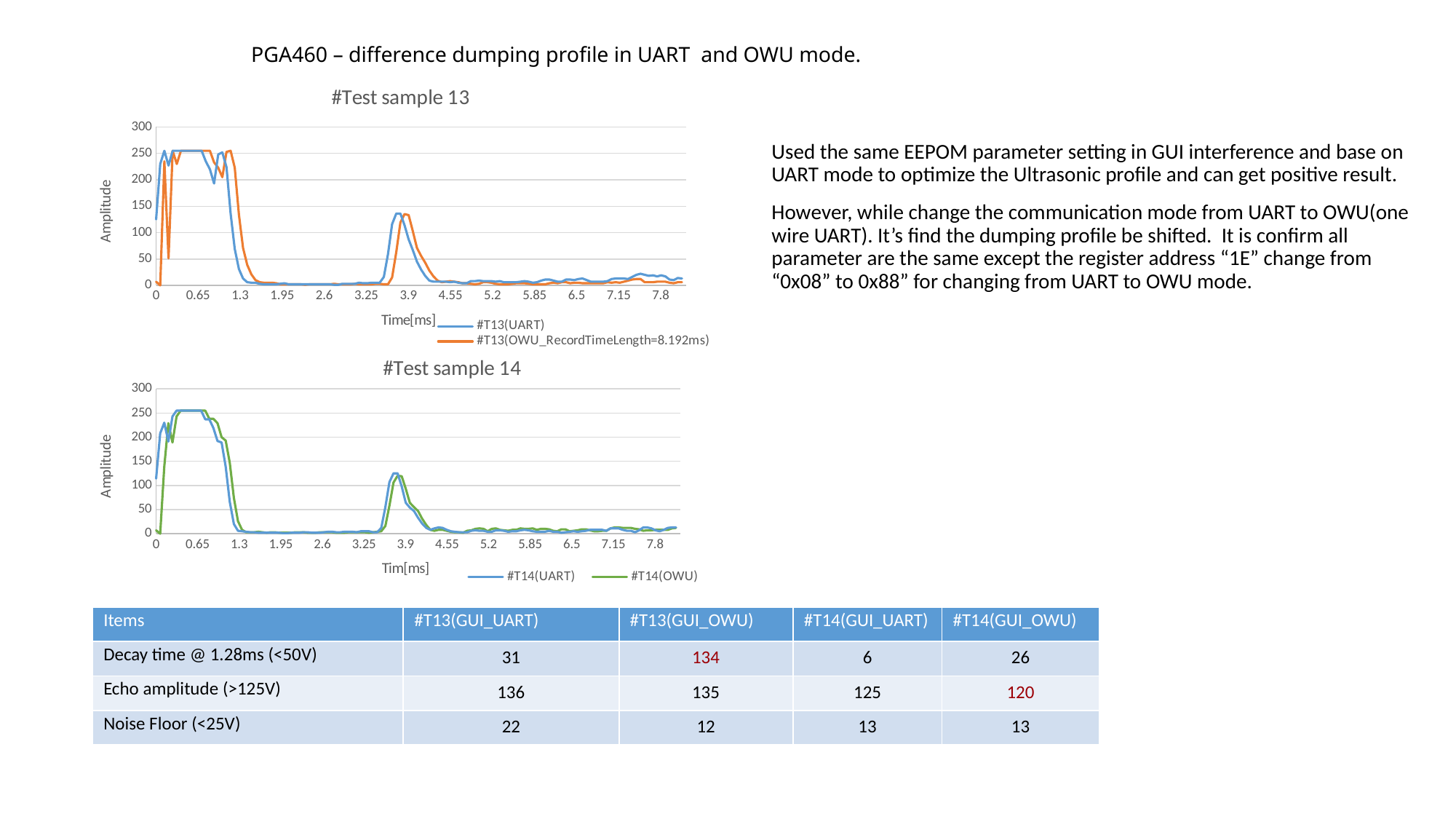
How many series does the legend of the "#Test sample 13" chart list? 2 In the "#Test sample 13" chart, what is the label of the orange series in the legend? #T13(OWU_RecordTimeLength=8.192ms) In the "#Test sample 14" chart, is the peak value of the #T14(UART) series near 3.9 ms greater or less than 100? greater How many series does the legend of the "#Test sample 14" chart list? 2 In the "#Test sample 14" chart, is the value of the #T14(OWU) series at 0.65 ms greater or less than 200? greater What kind of chart is "#Test sample 13"? line chart In the "#Test sample 13" chart, is the value of the #T13(UART) series at 2.6 ms greater or less than 50? less What kind of chart is "#Test sample 14"? line chart In the "#Test sample 14" chart, what is the label of the green series in the legend? #T14(OWU) In the "#Test sample 14" chart, do the values of the #T14(UART) series rise or fall between 0.65 ms and 1.3 ms? fall